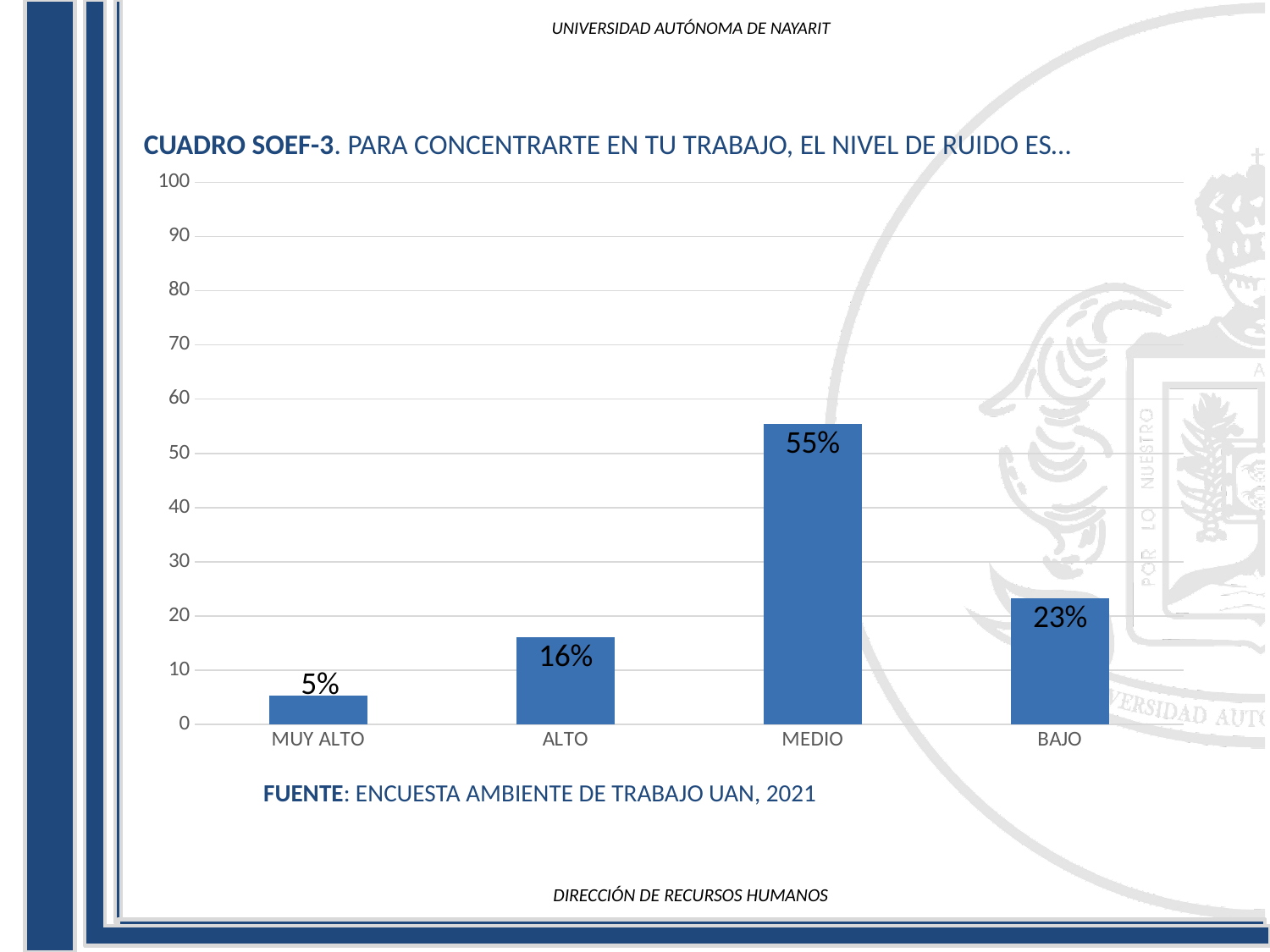
What is the difference between the values for MEDIO and BAJO? 32% Which category has the highest value? MEDIO Which is larger, the value for ALTO or the value for BAJO? BAJO Which category has the lowest value? MUY ALTO What is the value for MEDIO? 55% Is the value for MEDIO greater or less than 50? greater How many categories are shown on the x axis? 4 What kind of chart is shown on the slide? Bar chart What is the value for BAJO? 23% What is the value for MUY ALTO? 5% What source is cited below the chart? ENCUESTA AMBIENTE DE TRABAJO UAN, 2021 What is the value for ALTO? 16%